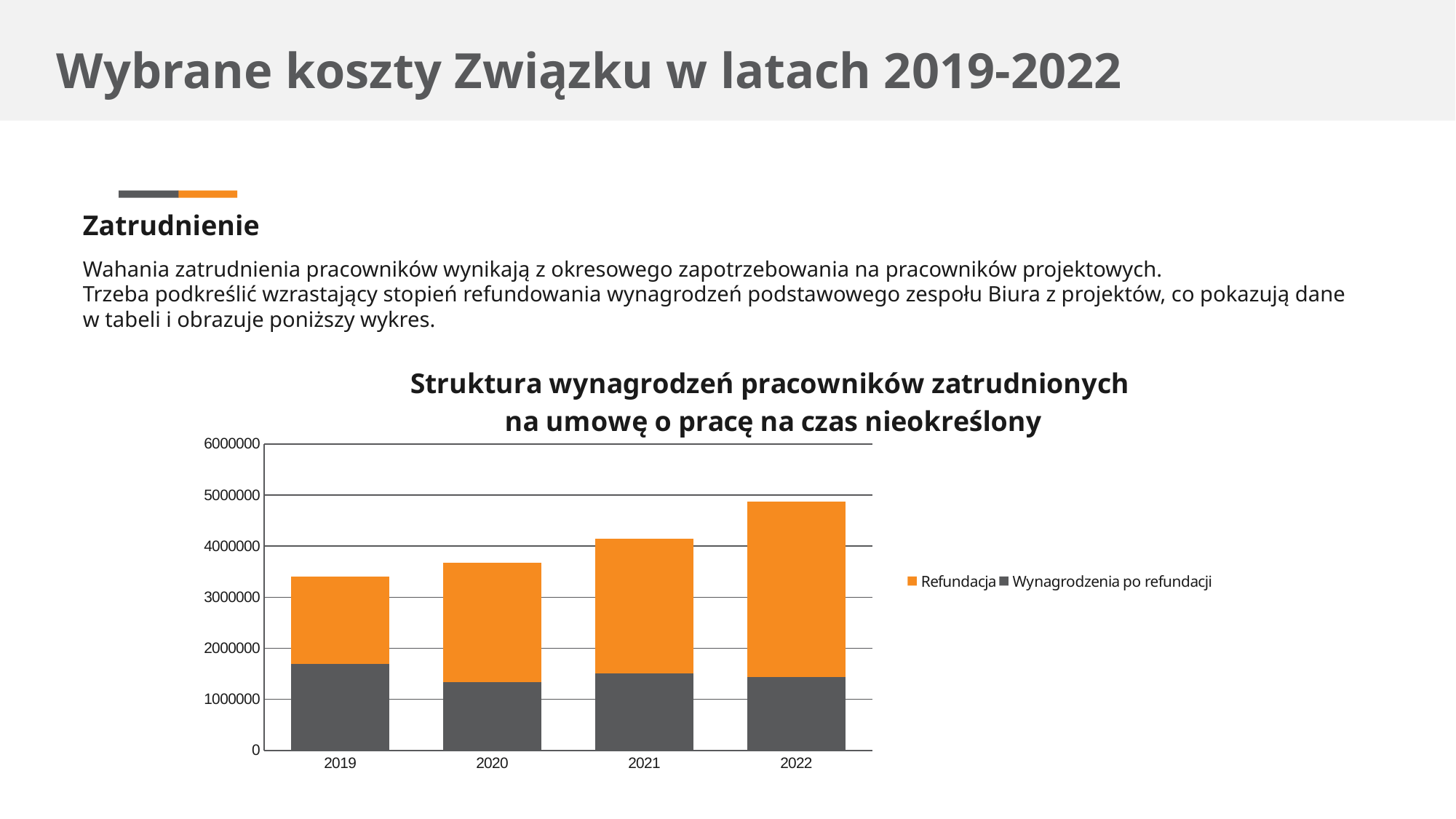
Which series is shown in orange in the chart? Refundacja What is the title of the chart? Struktura wynagrodzeń pracowników zatrudnionych na umowę o pracę na czas nieokreślony Is the Wynagrodzenia po refundacji value for 2019 greater or less than 2000000? less How many years are shown on the x axis of the chart? 4 Which year has the tallest total bar in the chart? 2022 Which year has the shortest total bar in the chart? 2019 How many series does the chart legend list? 2 Is the total bar for 2022 greater or less than 4000000? greater What kind of chart is shown on the slide? Stacked bar chart Which year has the largest Wynagrodzenia po refundacji segment, 2019 or 2021? 2019 Do the total bar heights rise or fall from 2019 to 2022? Rise Is the total bar for 2019 greater or less than 4000000? less